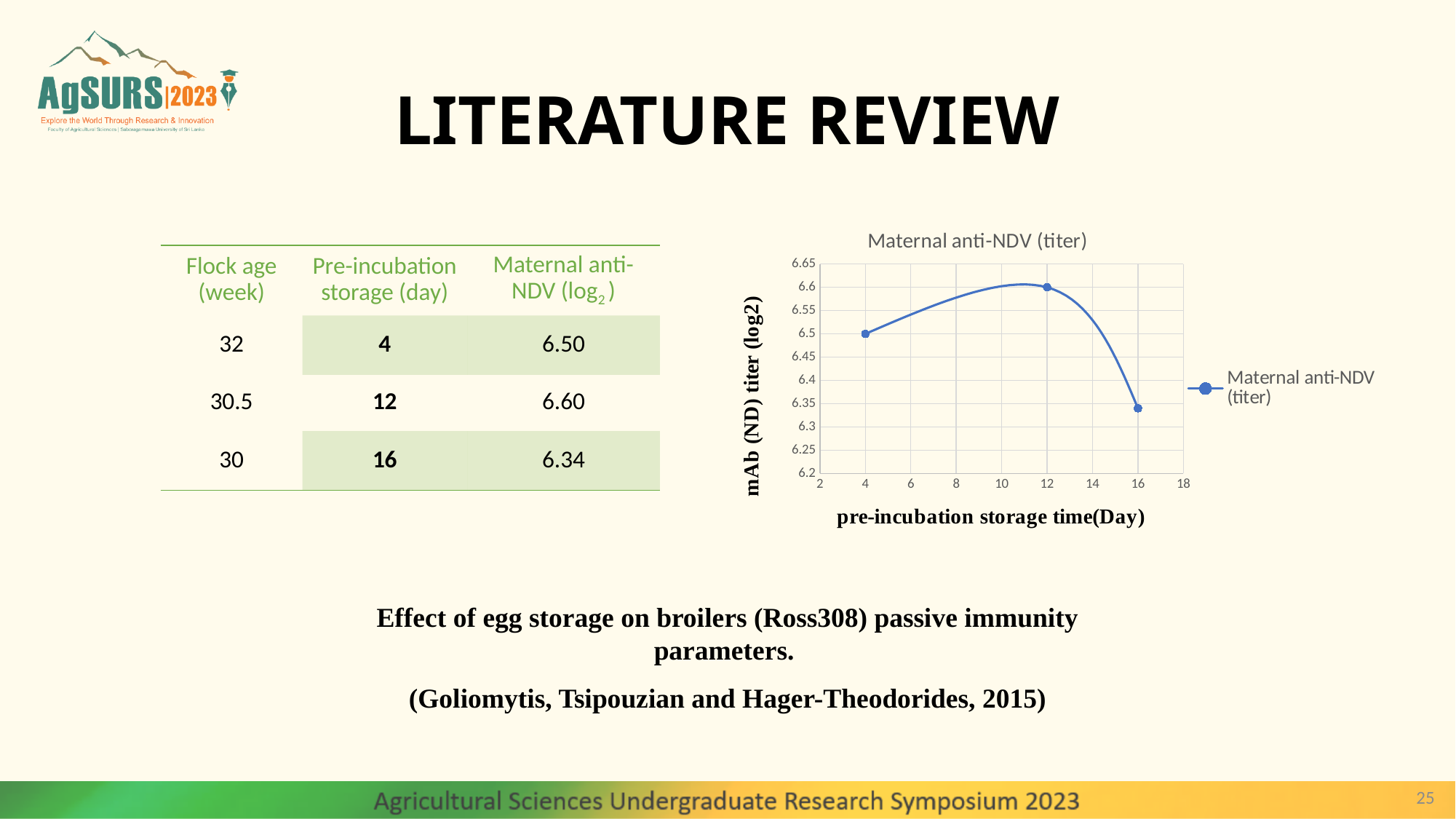
How many series does the legend of the chart list? 1 How does the maternal anti-NDV titer change as pre-incubation storage time increases from 4 to 16 days? rises then falls How many data points are plotted on the Maternal anti-NDV (titer) chart? 3 What is the difference between the maternal anti-NDV titer at 12 days and at 16 days of storage? 0.26 What is the maternal anti-NDV titer at a pre-incubation storage time of 4 days? 6.50 At which pre-incubation storage time is the maternal anti-NDV titer highest? 12 days At which pre-incubation storage time is the maternal anti-NDV titer lowest? 16 days Is the maternal anti-NDV titer at 16 days of storage greater or less than 6.4? less Which has a higher maternal anti-NDV titer: 4 days or 16 days of pre-incubation storage? 4 days What is the maternal anti-NDV titer at a pre-incubation storage time of 12 days? 6.60 What kind of chart is shown on the slide? line chart What is the maternal anti-NDV titer at a pre-incubation storage time of 16 days? 6.34